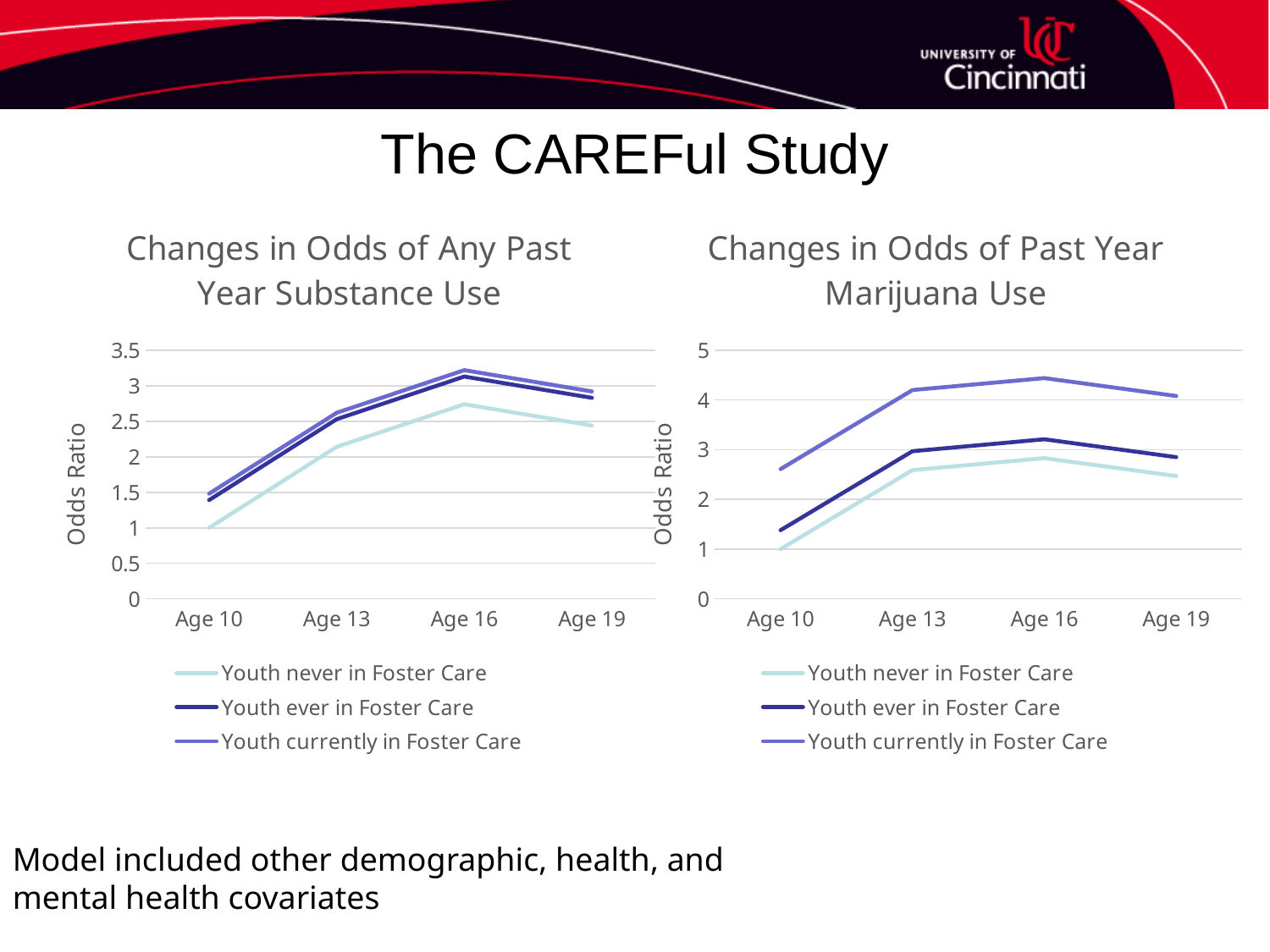
On the 'Changes in Odds of Past Year Marijuana Use' chart, is the value for Youth currently in Foster Care at Age 13 greater or less than 4? greater How many series does the legend of the 'Changes in Odds of Past Year Marijuana Use' chart list? 3 On the 'Changes in Odds of Any Past Year Substance Use' chart, is the value for Youth never in Foster Care at Age 16 greater or less than 3? less On the 'Changes in Odds of Any Past Year Substance Use' chart, at which age is the odds ratio for Youth ever in Foster Care lowest? Age 10 On the 'Changes in Odds of Any Past Year Substance Use' chart, is the value for Youth currently in Foster Care at Age 16 greater or less than 3? greater On the 'Changes in Odds of Any Past Year Substance Use' chart, what is the odds ratio for Youth never in Foster Care at Age 10? 1 On the 'Changes in Odds of Past Year Marijuana Use' chart, at which age is the odds ratio for Youth currently in Foster Care highest? Age 16 How many age categories are shown on the x axis of the 'Changes in Odds of Any Past Year Substance Use' chart? 4 On the 'Changes in Odds of Past Year Marijuana Use' chart, what is the odds ratio for Youth never in Foster Care at Age 10? 1 On the 'Changes in Odds of Past Year Marijuana Use' chart, at Age 19, which is larger: the value for Youth currently in Foster Care or Youth never in Foster Care? Youth currently in Foster Care What kind of chart is the 'Changes in Odds of Any Past Year Substance Use' chart? Line chart